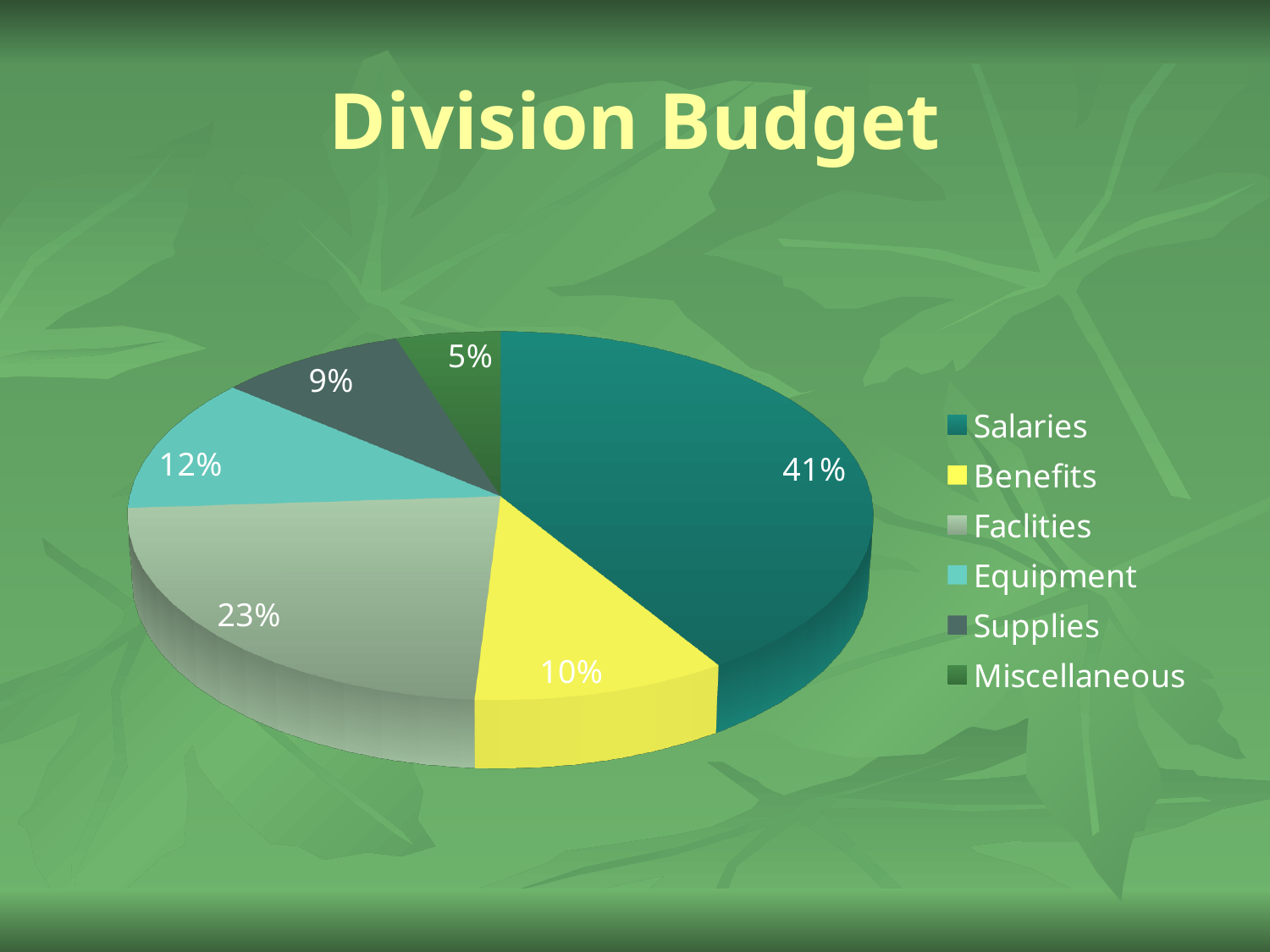
How many categories does the pie chart show? 6 Which is larger, the share for Benefits or the share for Supplies? Benefits Which category has the smallest share of the Division Budget? Miscellaneous What is the difference in percentage points between Salaries and Faclities? 18 What is the value shown for Equipment? 12% What type of chart is shown on the slide? pie chart What percentage of the budget is allocated to Faclities? 23% What share of the Division Budget goes to Salaries? 41% What is the combined share of Supplies and Miscellaneous? 14% What is the title of the chart? Division Budget Which category has the largest share of the Division Budget? Salaries What percentage is shown for Miscellaneous? 5%